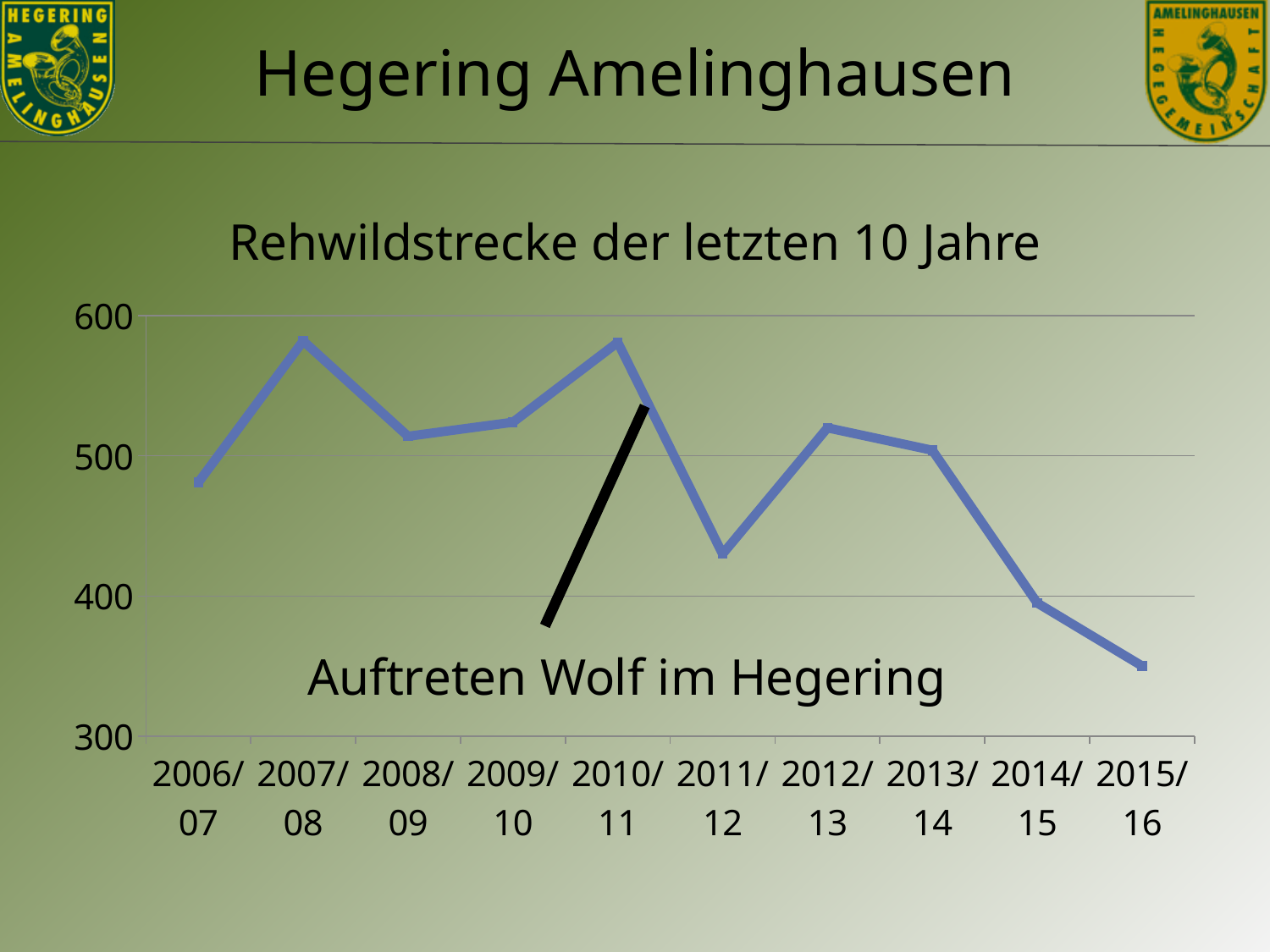
Is the value for 2006/07 greater or less than 500? less Do the values rise or fall from 2013/14 to 2015/16? fall Is the value for 2011/12 greater or less than 500? less Is the value for 2015/16 greater or less than 400? less How many hunting years are plotted on the x axis? 10 Which hunting year has the lowest value? 2015/16 What event does the annotation on the chart point to? Auftreten Wolf im Hegering Which is larger, the value for 2011/12 or the value for 2012/13? 2012/13 What kind of chart is shown on the slide? line chart What is the title of the chart? Rehwildstrecke der letzten 10 Jahre